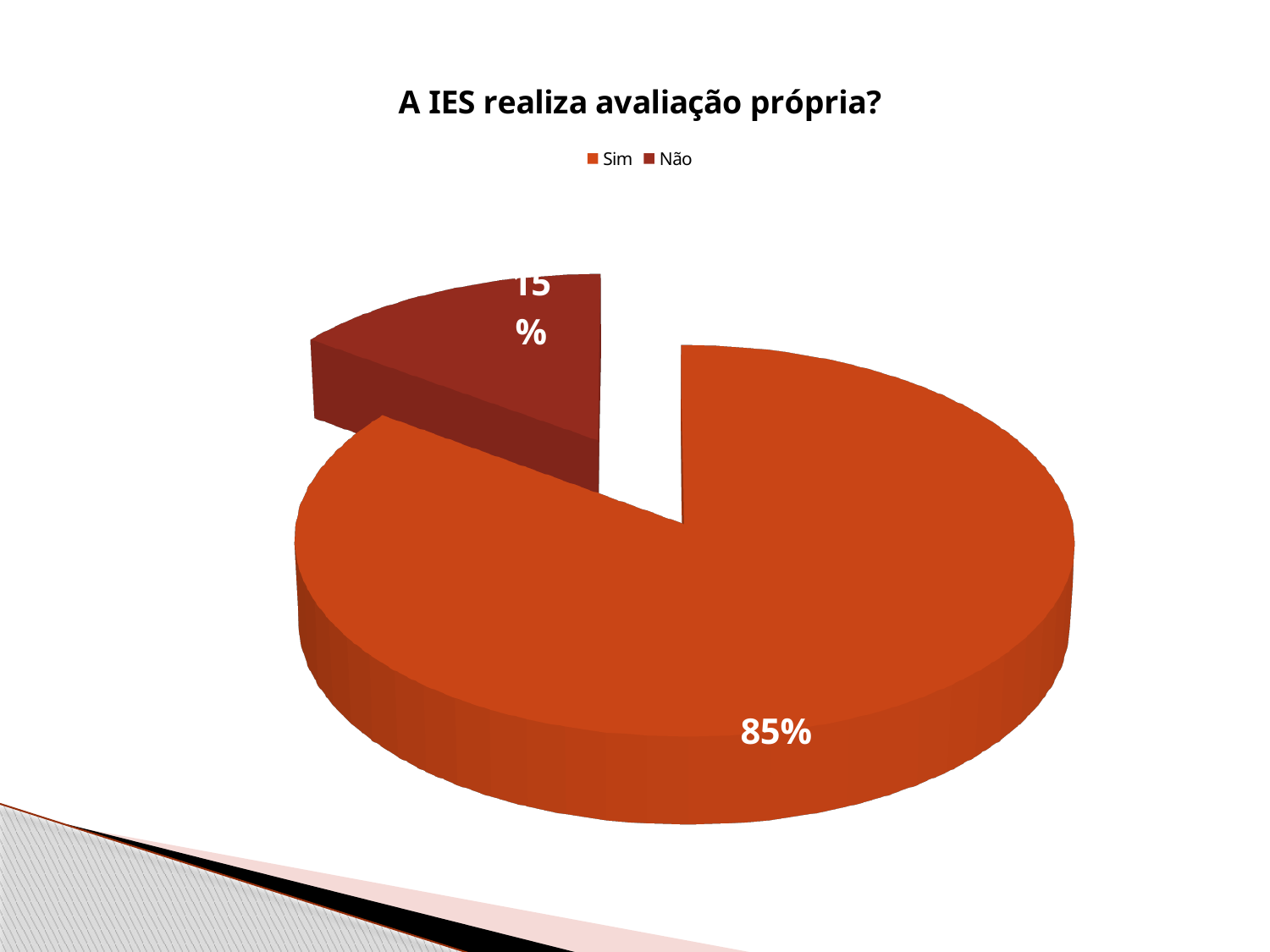
What percentage of the pie is labelled for "Sim"? 85% What percentage of the pie is labelled for "Não"? 15% Which is larger, the "Sim" slice or the "Não" slice? Sim Which category has the largest share of the pie? Sim What kind of chart is shown on the slide? pie chart How many entries does the legend list? 2 What are the two legend entries of the chart? Sim and Não Which category has the smallest share of the pie? Não What is the title of the chart? A IES realiza avaliação própria? What is the difference in percentage points between the "Sim" and "Não" slices? 70 How many slices does the pie chart have? 2